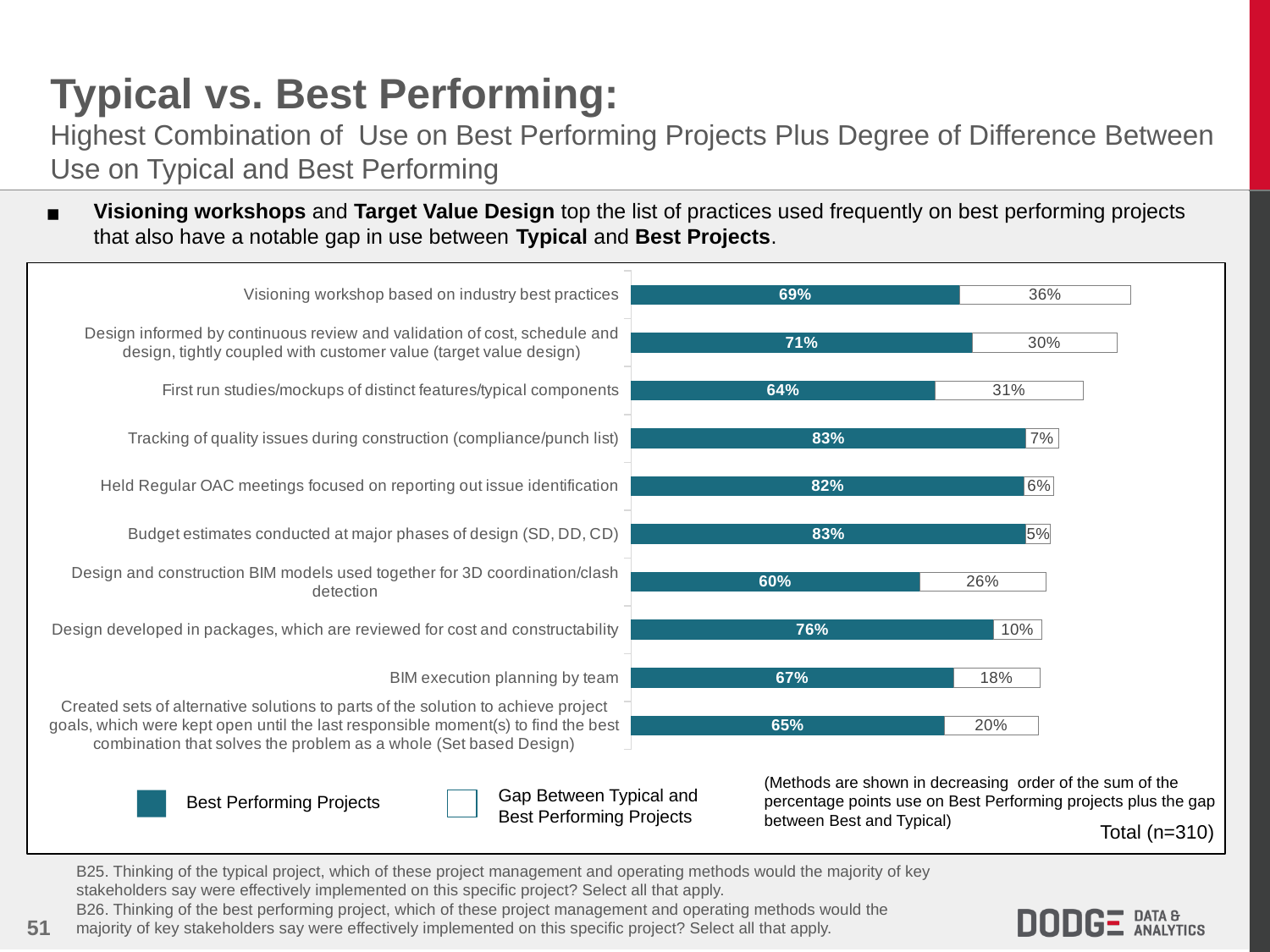
Which practice has the largest Gap Between Typical and Best Performing Projects? Visioning workshop based on industry best practices What is the total of the stacked bar for 'Design informed by continuous review and validation of cost, schedule and design, tightly coupled with customer value (target value design)'? 101% Which is larger: the Best Performing Projects value for 'Design developed in packages, which are reviewed for cost and constructability' or for 'BIM execution planning by team'? Design developed in packages, which are reviewed for cost and constructability How many practices (categories) are plotted in the chart? 10 How many series does the chart legend list? 2 What is the difference between the Best Performing Projects values for 'Tracking of quality issues during construction (compliance/punch list)' and 'First run studies/mockups of distinct features/typical components'? 19 percentage points What is the Gap Between Typical and Best Performing Projects value for 'BIM execution planning by team'? 18% Which practice has the lowest Best Performing Projects value? Design and construction BIM models used together for 3D coordination/clash detection What is the Best Performing Projects value for 'Visioning workshop based on industry best practices'? 69% What kind of chart is shown on the slide? Stacked bar chart What colour represents the Best Performing Projects series in the chart? Teal Which practice has the smallest Gap Between Typical and Best Performing Projects? Budget estimates conducted at major phases of design (SD, DD, CD)